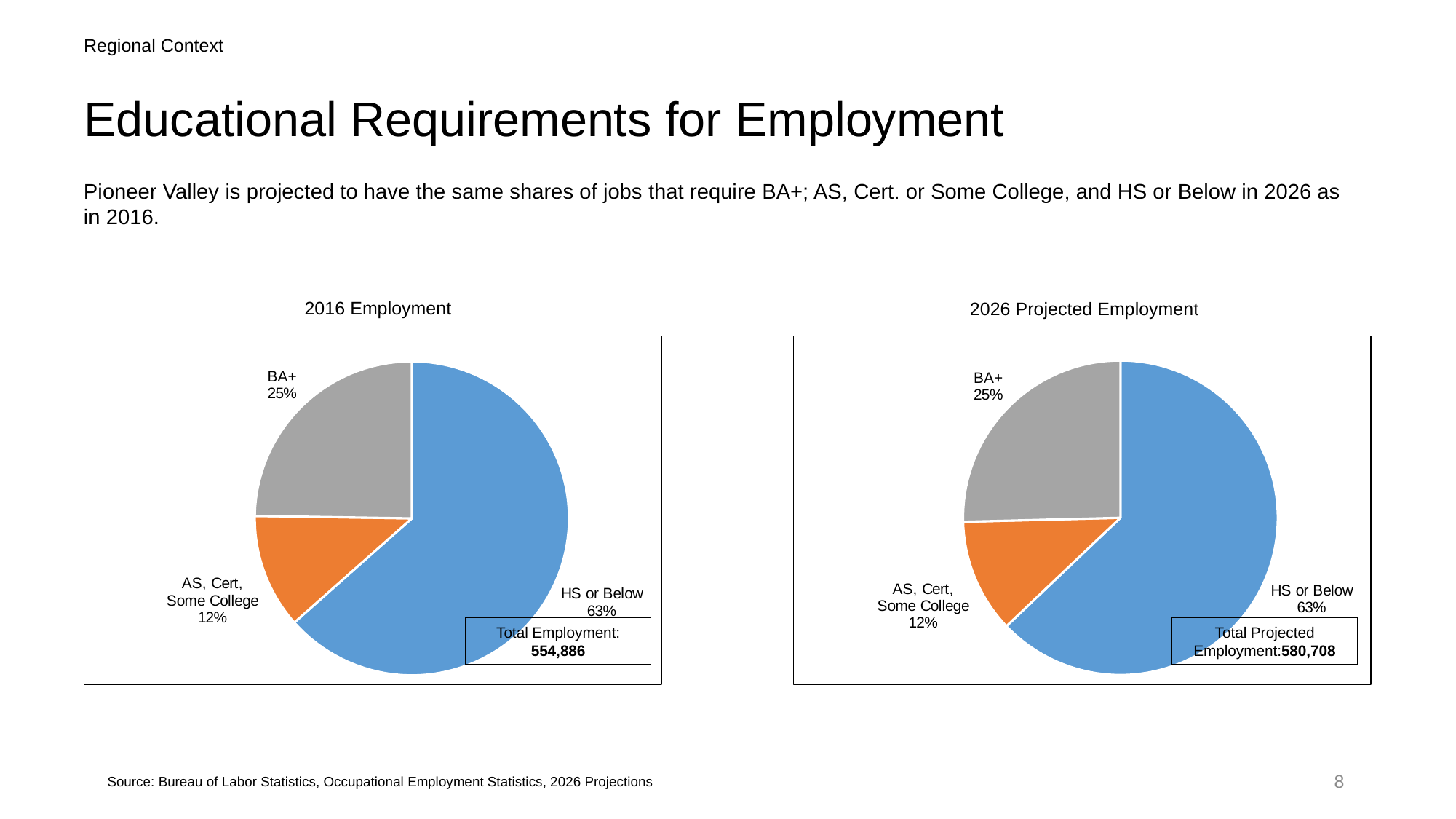
How many categories does the 2016 Employment pie chart show? 3 In the 2016 Employment chart, what share of jobs require BA+? 25% What total employment figure is shown on the 2016 Employment chart? 554,886 In the 2026 Projected Employment chart, which is larger: the BA+ share or the AS, Cert, Some College share? BA+ In the 2026 Projected Employment chart, what share of jobs require HS or Below? 63% What type of chart is the 2026 Projected Employment chart? Pie chart In the 2026 Projected Employment chart, what share of jobs require AS, Cert, Some College? 12% In the 2016 Employment chart, what is the difference in percentage points between the HS or Below share and the BA+ share? 38 percentage points What total projected employment figure is shown on the 2026 Projected Employment chart? 580,708 In the 2026 Projected Employment chart, which category has the smallest share? AS, Cert, Some College In the 2016 Employment chart, which category has the largest share? HS or Below